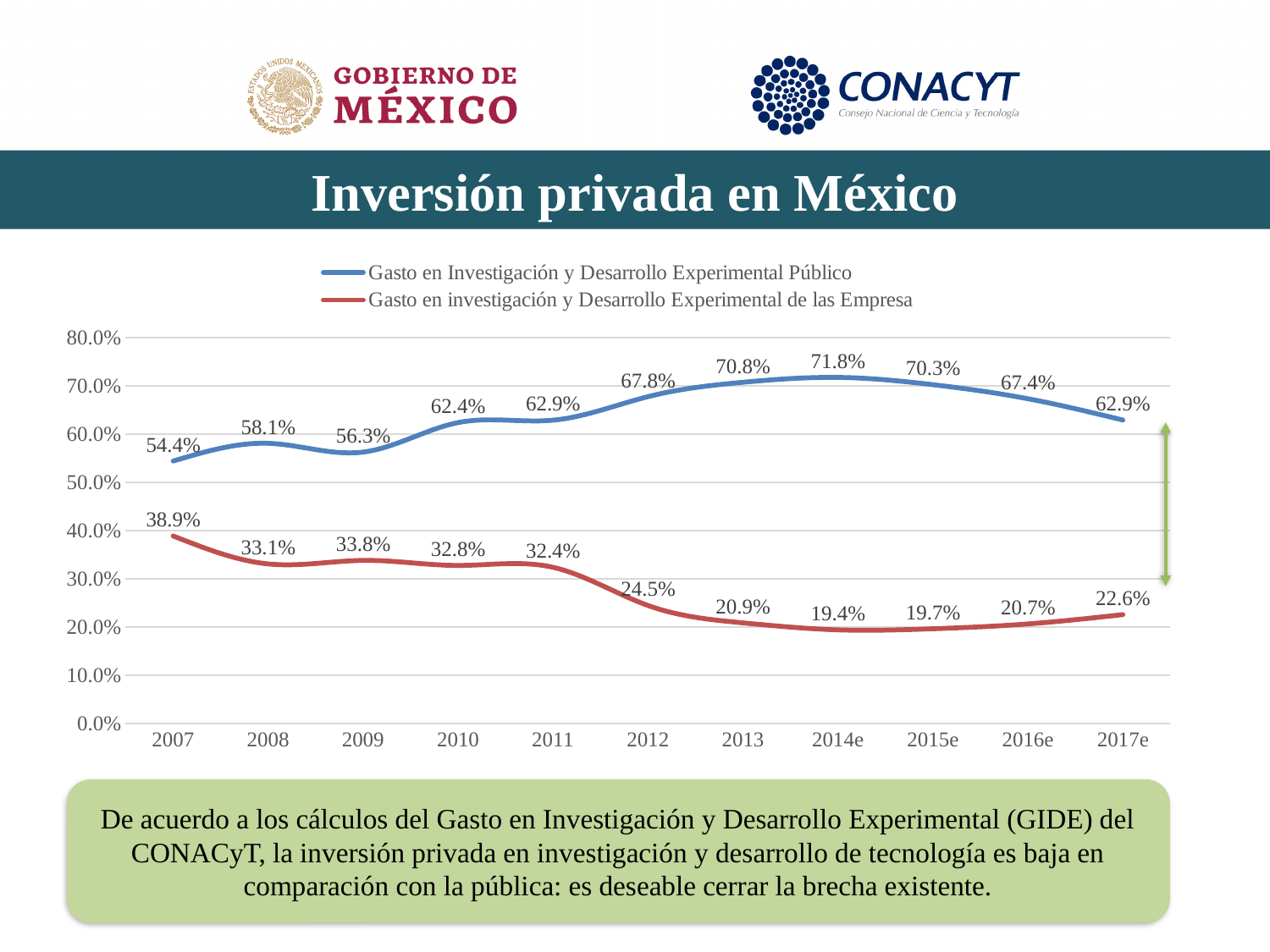
What colour is the line for Gasto en Investigación y Desarrollo Experimental Público? Blue In which year is Gasto en investigación y Desarrollo Experimental de las Empresa lowest? 2014e How many years are shown on the x axis? 11 What is the value of Gasto en investigación y Desarrollo Experimental de las Empresa in 2017e? 22.6% In which year does Gasto en Investigación y Desarrollo Experimental Público reach its highest value? 2014e What is the difference between the Público and Empresa values in 2017e? 40.3% What is the value of Gasto en investigación y Desarrollo Experimental de las Empresa in 2014e? 19.4% How many series does the legend list? 2 Which is larger in 2012: the Público value or the Empresa value? Público What kind of chart is shown on the slide? Line chart Does Gasto en investigación y Desarrollo Experimental de las Empresa rise or fall from 2007 to 2014e? Fall What is the value of Gasto en Investigación y Desarrollo Experimental Público in 2007? 54.4%